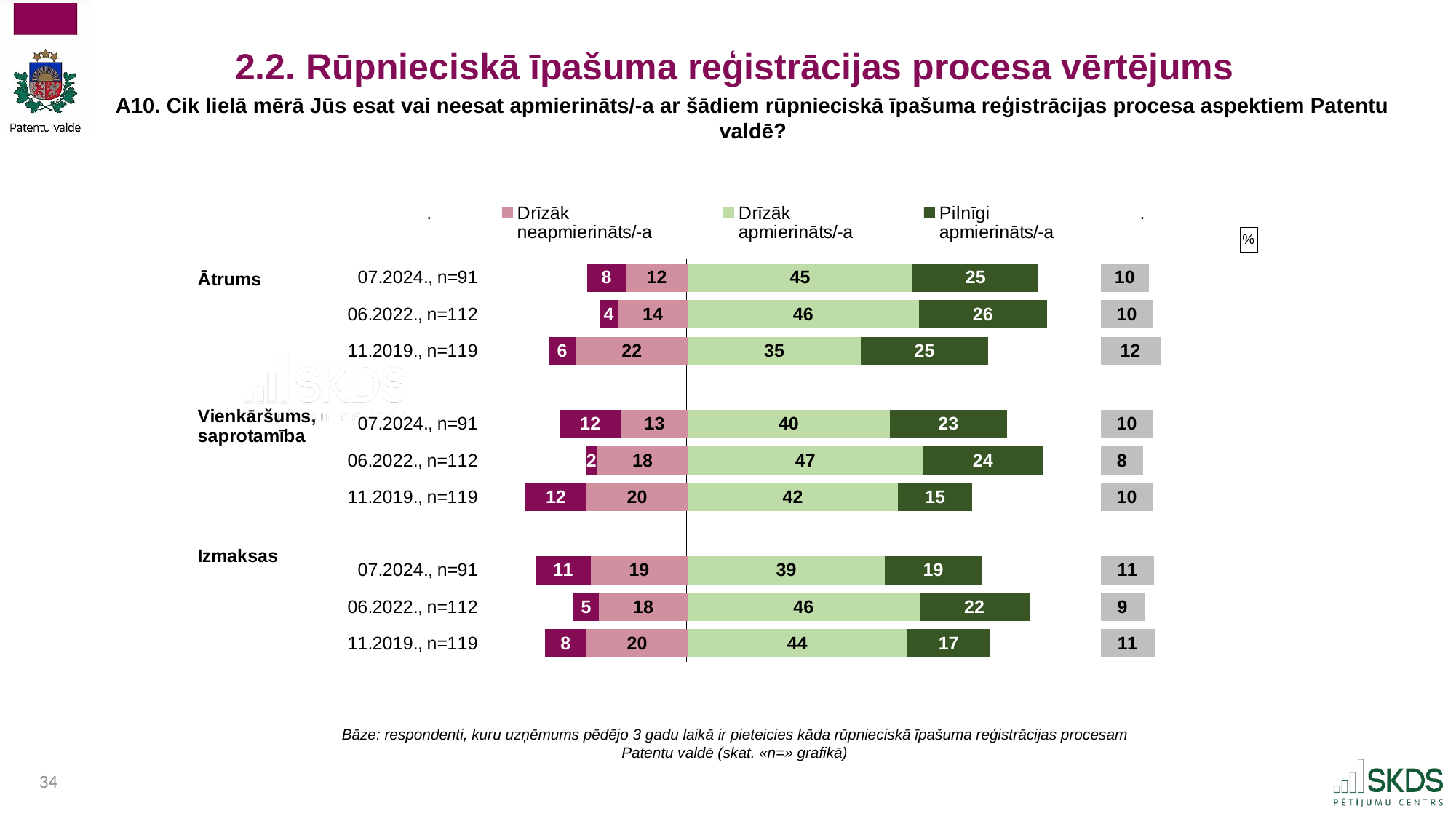
What is the value of "Pilnīgi apmierināts/-a" for Izmaksas in 11.2019 (n=119)? 17 For Ātrums, does the "Drīzāk neapmierināts/-a" value rise or fall from 11.2019 to 07.2024? Fall What is the value of "Pilnīgi apmierināts/-a" for Vienkāršums, saprotamība in 07.2024 (n=91)? 23 What kind of chart is shown on the slide? Stacked bar chart How many named series does the legend list? 3 What is the value of "Drīzāk apmierināts/-a" for Ātrums in 07.2024 (n=91)? 45 Which row has the lowest "Pilnīgi apmierināts/-a" value? Vienkāršums, saprotamība, 11.2019 (15) How many bars (aspect-year rows) are shown in the chart? 9 Which row has the highest "Drīzāk apmierināts/-a" value? Vienkāršums, saprotamība, 06.2022 (47) For Ātrums, how much higher is the "Drīzāk apmierināts/-a" value in 06.2022 than in 11.2019? 11 In 07.2024, which has the larger "Drīzāk neapmierināts/-a" value: Izmaksas or Ātrums? Izmaksas Which three aspects of the registration process are evaluated in the chart? Ātrums; Vienkāršums, saprotamība; Izmaksas